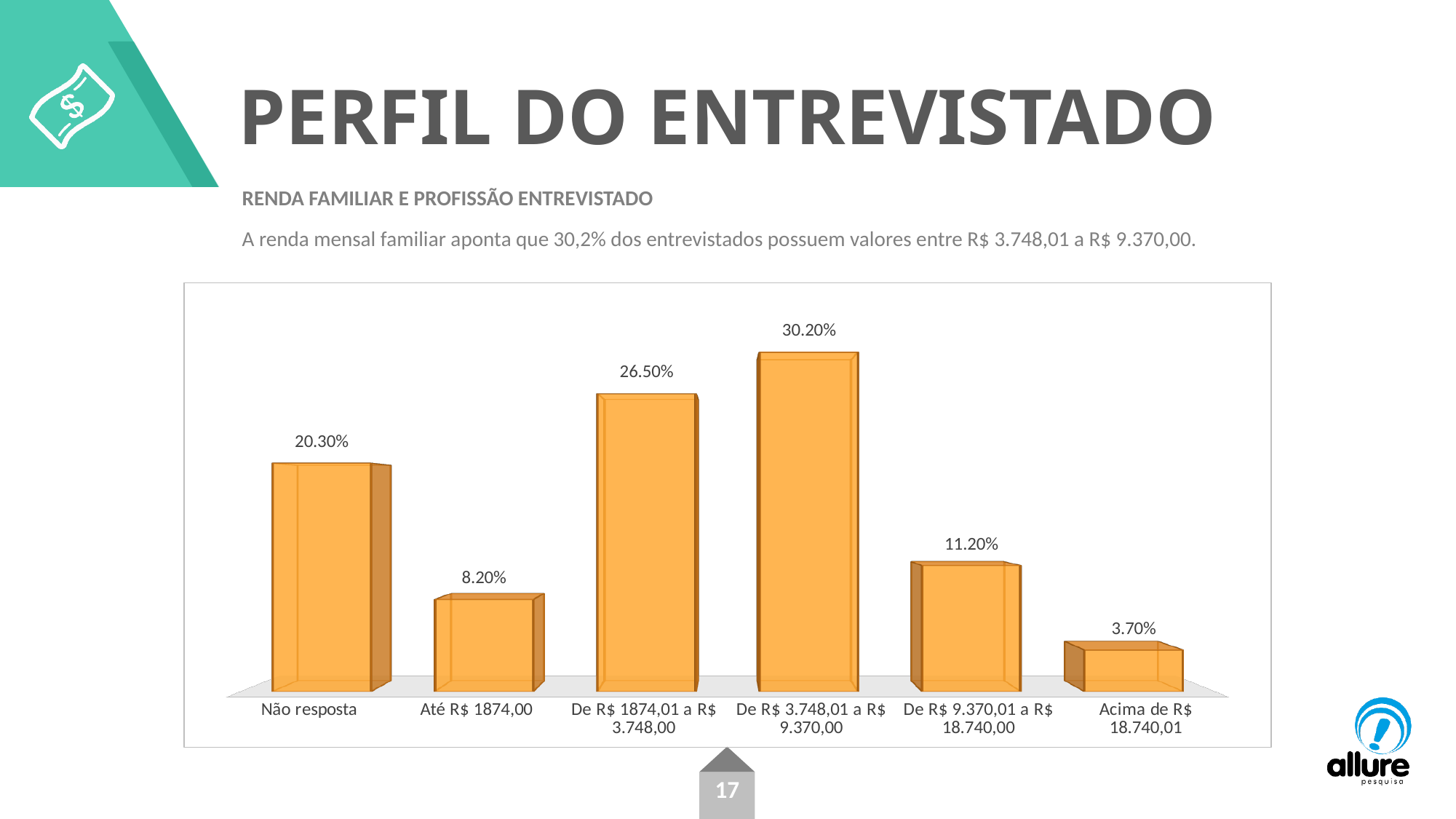
What is the difference between the values for 'De R$ 3.748,01 a R$ 9.370,00' and 'De R$ 1874,01 a R$ 3.748,00'? 3.70% Which category has the highest value? De R$ 3.748,01 a R$ 9.370,00 What is the value for the 'Até R$ 1874,00' category? 8.20% What is the difference between the values for 'Não resposta' and 'De R$ 9.370,01 a R$ 18.740,00'? 9.10% What is the value for the 'Não resposta' category? 20.30% What is the value for the 'De R$ 3.748,01 a R$ 9.370,00' category? 30.20% What kind of chart is shown on the slide? Bar chart Which category has the lowest value? Acima de R$ 18.740,01 What colour are the bars in the chart? Orange Which is larger, the value for 'Até R$ 1874,00' or the value for 'De R$ 9.370,01 a R$ 18.740,00'? De R$ 9.370,01 a R$ 18.740,00 How many categories are shown in the chart? 6 What is the value for the 'Acima de R$ 18.740,01' category? 3.70%